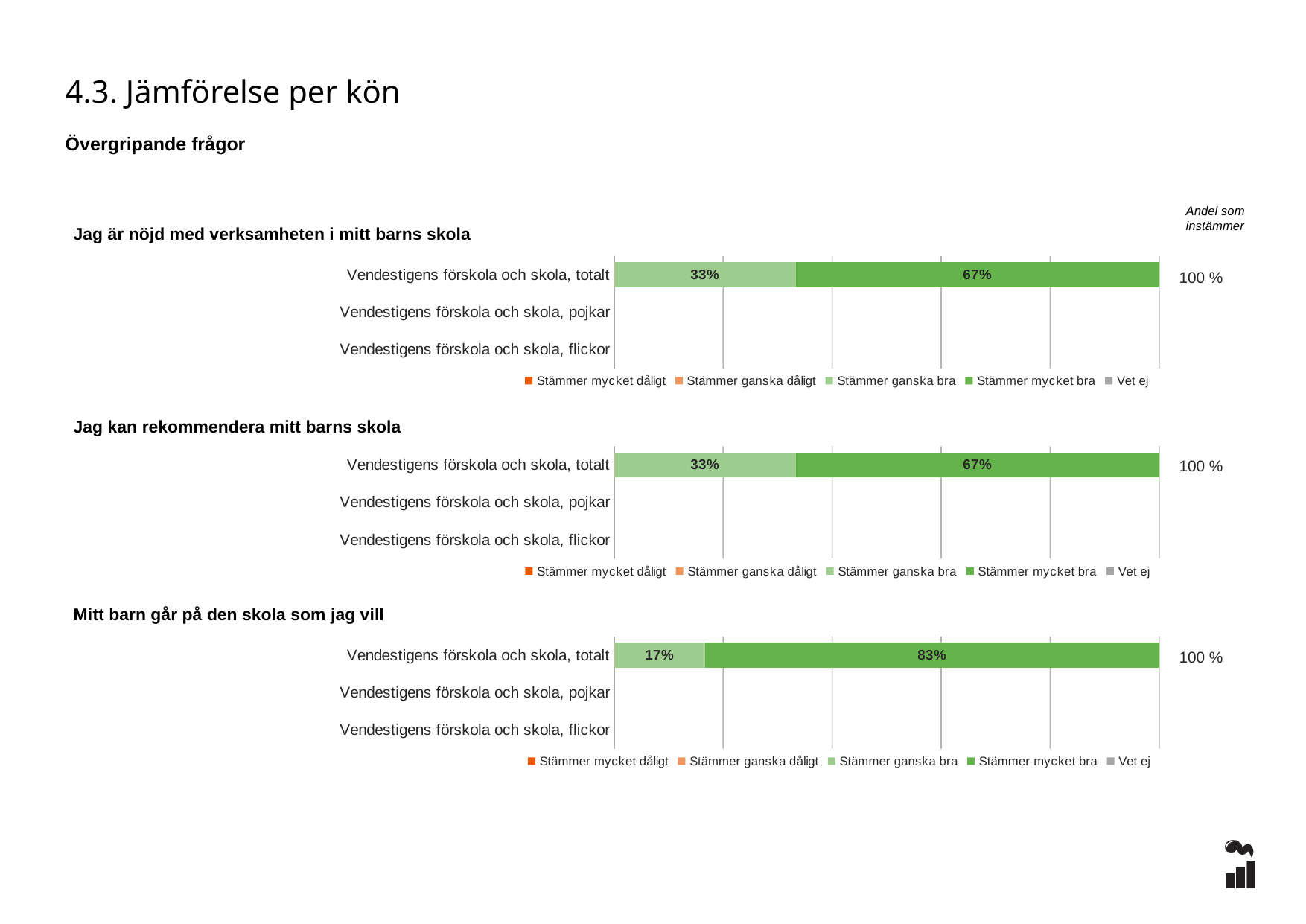
In the chart 'Jag är nöjd med verksamheten i mitt barns skola', what is the value of 'Stämmer ganska bra' for 'Vendestigens förskola och skola, totalt'? 33% In the chart 'Mitt barn går på den skola som jag vill', what is the difference between the 'Stämmer mycket bra' and 'Stämmer ganska bra' values for 'Vendestigens förskola och skola, totalt'? 66% In the chart 'Jag är nöjd med verksamheten i mitt barns skola', what is the first legend entry? Stämmer mycket dåligt In the chart 'Jag är nöjd med verksamheten i mitt barns skola', what is the value of 'Stämmer mycket bra' for 'Vendestigens förskola och skola, totalt'? 67% In the chart 'Mitt barn går på den skola som jag vill', what is the value of 'Stämmer ganska bra' for 'Vendestigens förskola och skola, totalt'? 17% How many categories are shown on the y axis of the chart 'Mitt barn går på den skola som jag vill'? 3 In the chart 'Jag är nöjd med verksamheten i mitt barns skola', which is larger for 'Vendestigens förskola och skola, totalt': 'Stämmer ganska bra' or 'Stämmer mycket bra'? Stämmer mycket bra In the chart 'Mitt barn går på den skola som jag vill', what is the value of 'Stämmer mycket bra' for 'Vendestigens förskola och skola, totalt'? 83% In the chart 'Jag kan rekommendera mitt barns skola', what is the value of 'Stämmer mycket bra' for 'Vendestigens förskola och skola, totalt'? 67% How many series does the legend list in the chart 'Jag är nöjd med verksamheten i mitt barns skola'? 5 What kind of chart is 'Jag kan rekommendera mitt barns skola'? Stacked bar chart In the chart 'Jag kan rekommendera mitt barns skola', what is the total of the stacked bar for 'Vendestigens förskola och skola, totalt'? 100 %